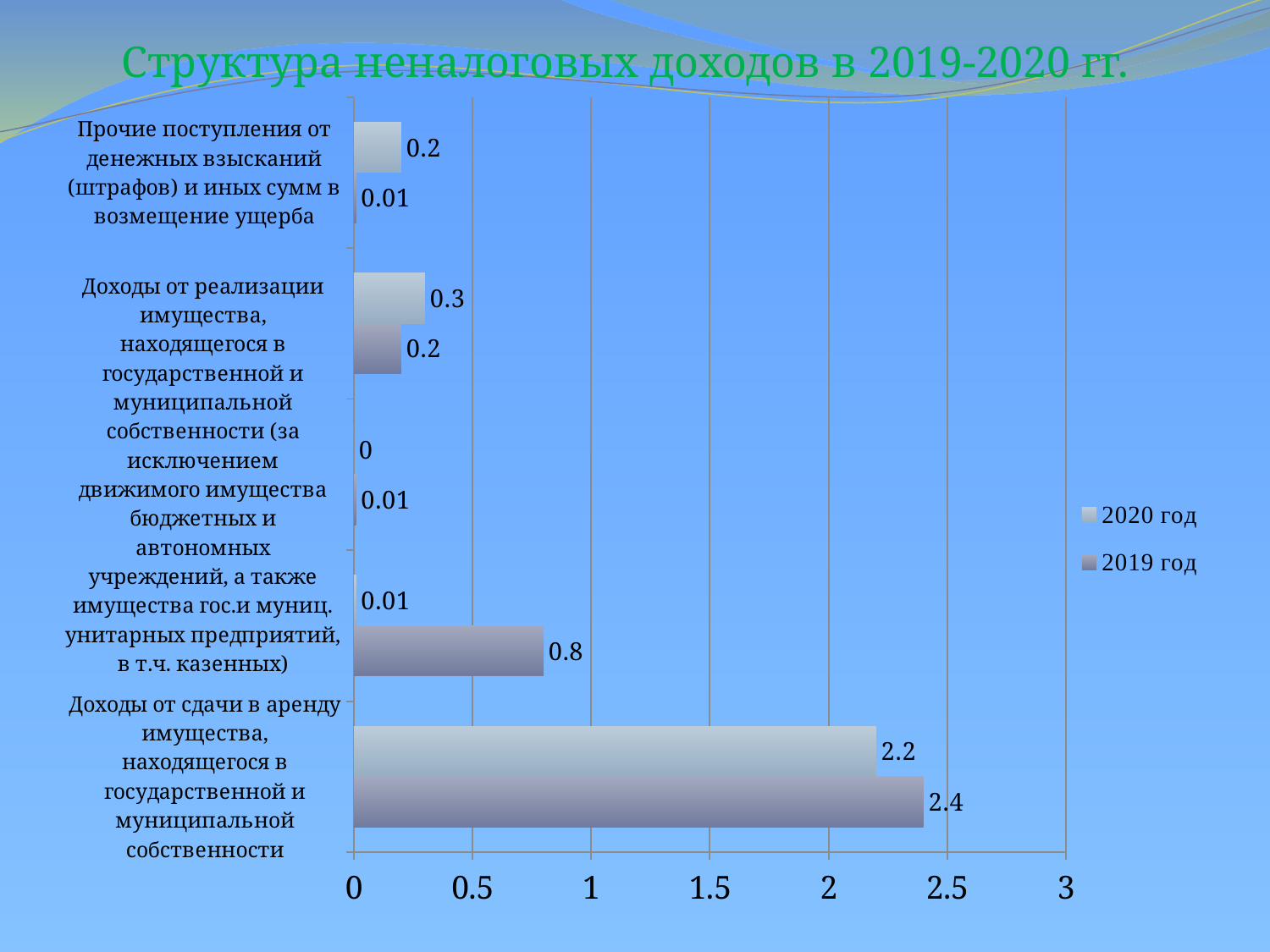
What is the 2020 год value for 'Прочие поступления от денежных взысканий (штрафов) и иных сумм в возмещение ущерба'? 0.2 What is the difference between the 2019 год and 2020 год values for 'Доходы от сдачи в аренду имущества'? 0.2 How many category groups of bars are plotted on the chart? 5 Which category has the highest 2019 год value? Доходы от сдачи в аренду имущества, находящегося в государственной и муниципальной собственности What is the 2019 год value for 'Прочие поступления от денежных взысканий (штрафов) и иных сумм в возмещение ущерба'? 0.01 Is the 2019 год value for 'Доходы от сдачи в аренду имущества' greater or less than 2? greater For 'Доходы от сдачи в аренду имущества', which year has the larger value, 2019 год or 2020 год? 2019 год What is the 2020 год value for 'Доходы от сдачи в аренду имущества, находящегося в государственной и муниципальной собственности'? 2.2 What is the title of the chart? Структура неналоговых доходов в 2019-2020 гг. How many series does the legend list? 2 What type of chart is shown on the slide? bar chart What is the 2019 год value for 'Доходы от сдачи в аренду имущества, находящегося в государственной и муниципальной собственности'? 2.4